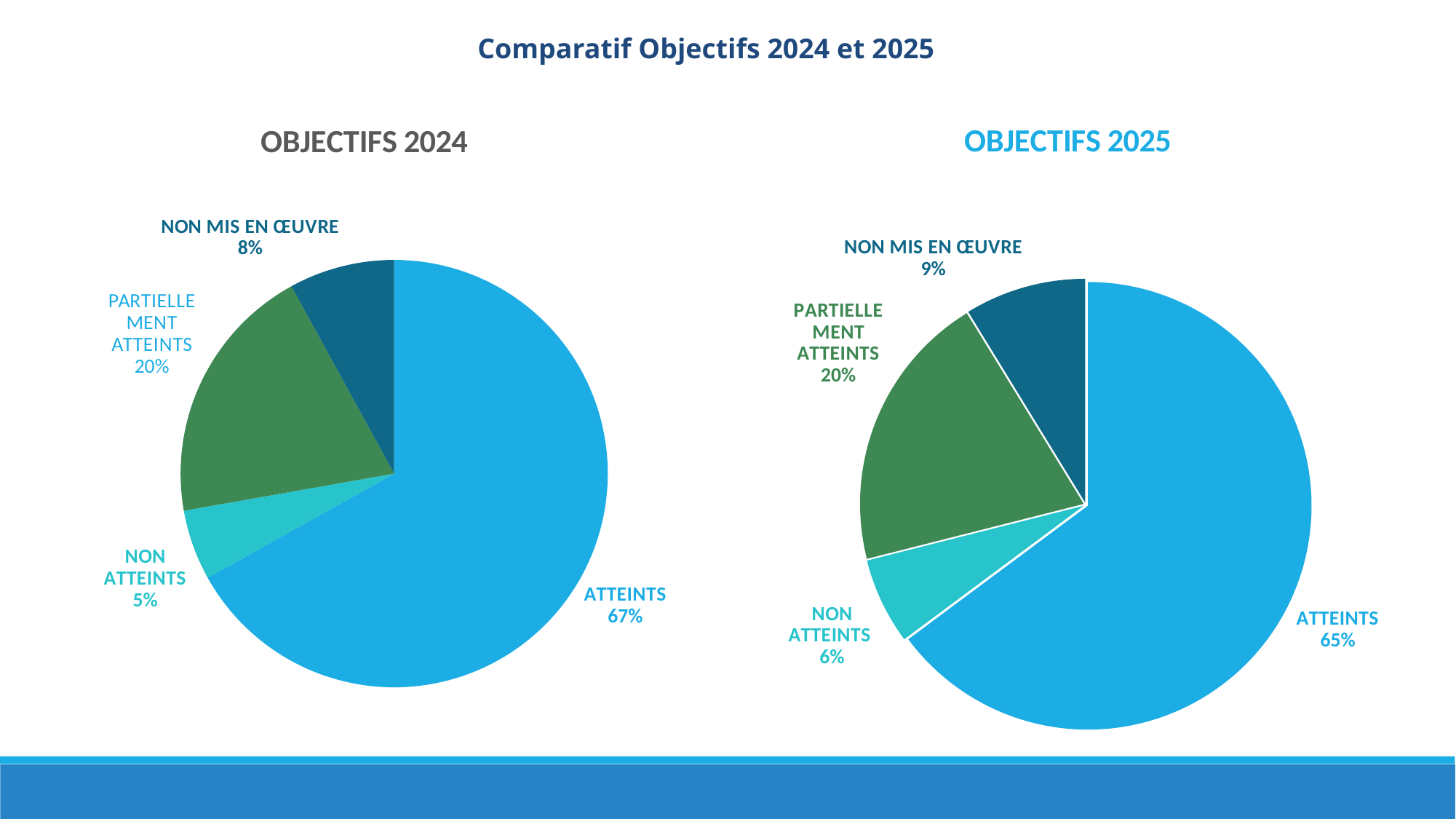
In the OBJECTIFS 2025 chart, what is the difference between PARTIELLEMENT ATTEINTS and NON ATTEINTS? 14% What is the overall title of the slide above the two charts? Comparatif Objectifs 2024 et 2025 In the OBJECTIFS 2024 chart, what share of the pie is ATTEINTS? 67% In the OBJECTIFS 2024 chart, which category has the smallest slice? NON ATTEINTS What is the difference between the ATTEINTS share in the OBJECTIFS 2024 chart and in the OBJECTIFS 2025 chart? 2% How many slices does the OBJECTIFS 2024 chart have? 4 In the OBJECTIFS 2025 chart, what share of the pie is ATTEINTS? 65% In the OBJECTIFS 2025 chart, what is the value for NON MIS EN ŒUVRE? 9% What kind of chart is the OBJECTIFS 2025 chart? Pie chart Is the NON MIS EN ŒUVRE share larger in the OBJECTIFS 2024 chart or the OBJECTIFS 2025 chart? OBJECTIFS 2025 In the OBJECTIFS 2024 chart, what is the value for NON ATTEINTS? 5% In the OBJECTIFS 2025 chart, which category has the largest slice? ATTEINTS